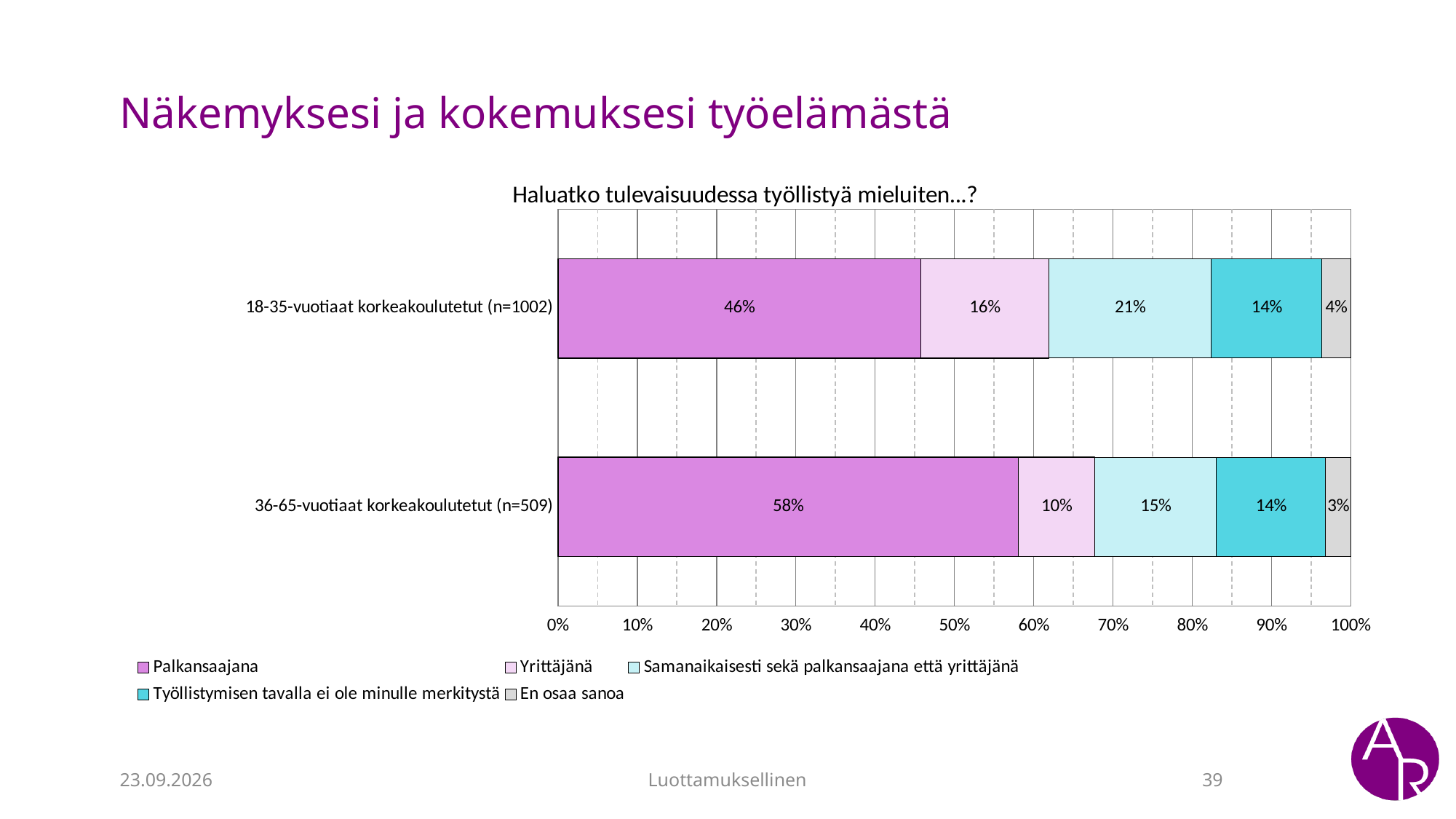
What is the value for Palkansaajana among 36-65-vuotiaat korkeakoulutetut (n=509)? 58% What is the title of the chart? Haluatko tulevaisuudessa työllistyä mieluiten…? Which group has the larger Yrittäjänä value, 18-35-vuotiaat korkeakoulutetut (n=1002) or 36-65-vuotiaat korkeakoulutetut (n=509)? 18-35-vuotiaat korkeakoulutetut (n=1002) Which series has the highest value in the 36-65-vuotiaat korkeakoulutetut (n=509) bar? Palkansaajana How many categories (bars) are shown in the chart? 2 What is the value for En osaa sanoa among 36-65-vuotiaat korkeakoulutetut (n=509)? 3% What is the difference between the Palkansaajana values for 36-65-vuotiaat korkeakoulutetut (n=509) and 18-35-vuotiaat korkeakoulutetut (n=1002)? 12 percentage points What is the value for Samanaikaisesti sekä palkansaajana että yrittäjänä among 18-35-vuotiaat korkeakoulutetut (n=1002)? 21% How many series does the legend list? 5 What kind of chart is shown on the slide? Stacked bar chart What is the value for Palkansaajana among 18-35-vuotiaat korkeakoulutetut (n=1002)? 46% What is the total of the stacked bar for 36-65-vuotiaat korkeakoulutetut (n=509)? 100%